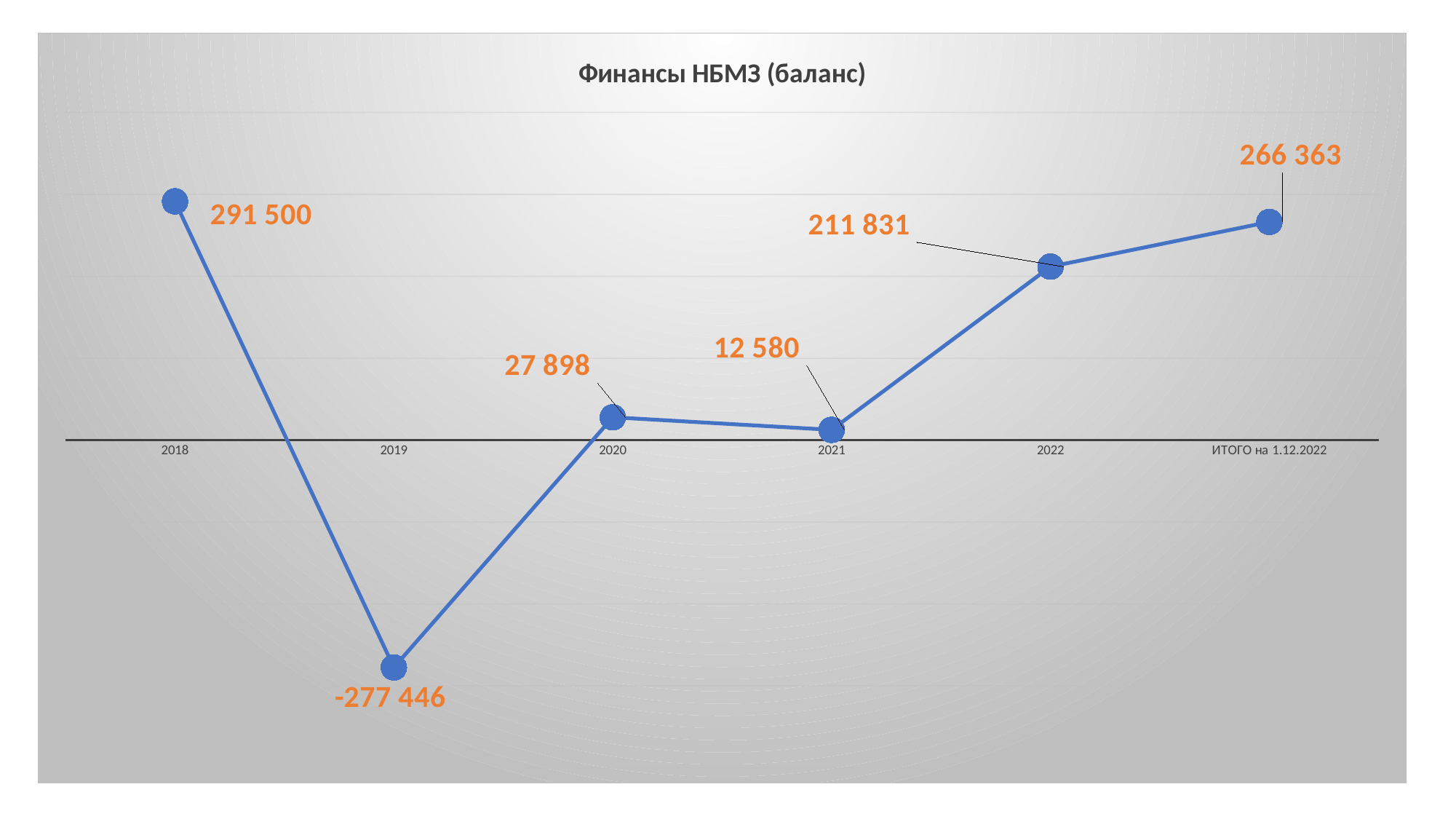
Which is larger, the value for 2020 or the value for 2022? 2022 What is the title of the chart? Финансы НБМЗ (баланс) How many data points are plotted on the chart? 6 What is the difference between the values for 2020 and 2021? 15 318 Which year has the lowest value? 2019 Which year has the highest value? 2018 What is the value for 2021? 12 580 What is the value labelled ИТОГО на 1.12.2022? 266 363 What is the value for 2019? -277 446 What is the value for 2018? 291 500 What kind of chart is shown? Line chart What is the difference between the values for 2022 and 2021? 199 251